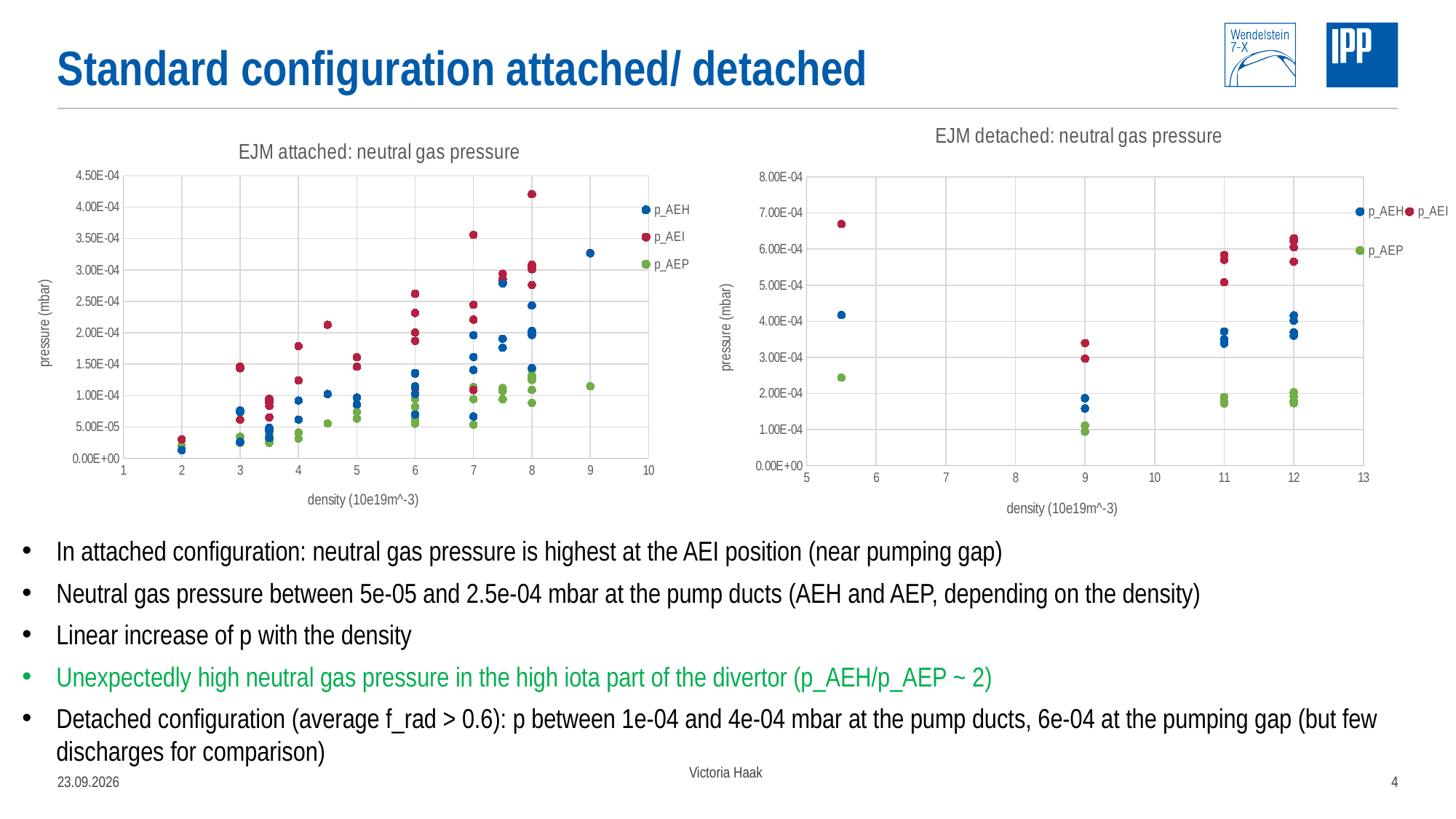
In the 'EJM detached: neutral gas pressure' chart, is the p_AEI value at density 5.5 greater or less than 6.00E-04? greater In the 'EJM attached: neutral gas pressure' chart, at density 4.5, which series has the larger value, p_AEI or p_AEH? p_AEI In the 'EJM attached: neutral gas pressure' chart, is the highest p_AEI value at density 8 greater or less than 4.00E-04? greater In the 'EJM detached: neutral gas pressure' chart, is the p_AEP value at density 5.5 greater or less than 3.00E-04? less What is the y-axis label of the 'EJM detached: neutral gas pressure' chart? pressure (mbar) What kind of chart is the 'EJM attached: neutral gas pressure' chart? scatter chart In the 'EJM attached: neutral gas pressure' chart, which series reaches the highest pressure values? p_AEI In the 'EJM attached: neutral gas pressure' chart, do the pressure values generally rise or fall as density increases? rise In the 'EJM detached: neutral gas pressure' chart, at density 9, which series has the larger values, p_AEI or p_AEP? p_AEI How many series does the legend of the 'EJM detached: neutral gas pressure' chart list? 3 What is the x-axis label of the 'EJM attached: neutral gas pressure' chart? density (10e19m^-3)